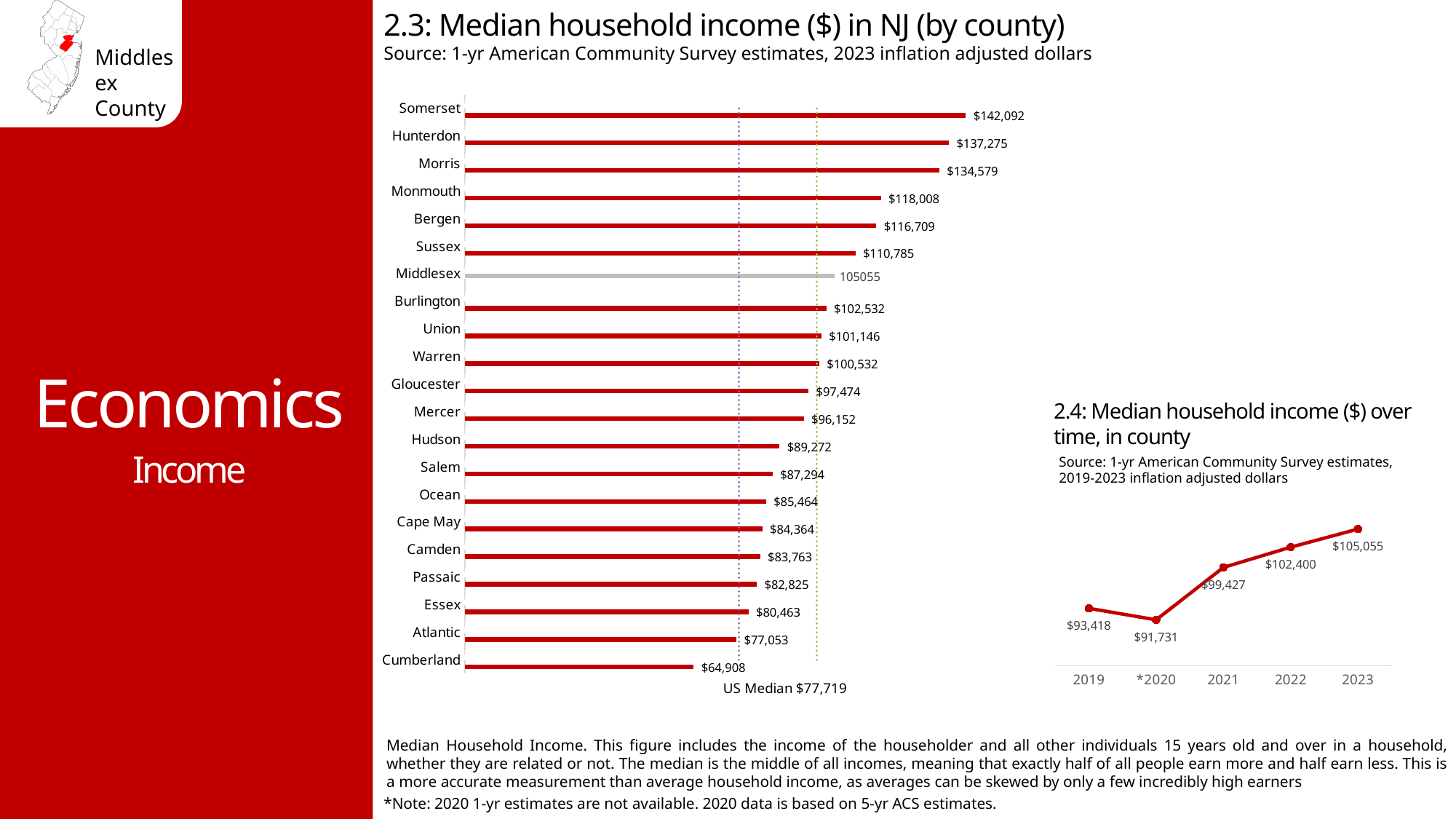
In chart 2.3 (Median household income in NJ by county), what is the median household income for Somerset? $142,092 In chart 2.4 (Median household income over time, in county), what is the value for 2021? $99,427 In chart 2.3 (Median household income in NJ by county), which has a higher median household income, Bergen or Hudson? Bergen What type of chart is chart 2.3 (Median household income in NJ by county)? Bar chart In chart 2.4 (Median household income over time, in county), what is the difference between the 2023 and 2019 values? $11,637 In chart 2.4 (Median household income over time, in county), do the values rise or fall from 2020 to 2023? Rise In chart 2.3 (Median household income in NJ by county), which county has the lowest median household income? Cumberland In chart 2.3 (Median household income in NJ by county), which county has the highest median household income? Somerset In chart 2.3 (Median household income in NJ by county), how many counties are shown? 21 In chart 2.3 (Median household income in NJ by county), what is the difference between Somerset's and Cumberland's median household income? $77,184 In chart 2.4 (Median household income over time, in county), which year has the lowest value? 2020 In chart 2.3 (Median household income in NJ by county), what is the median household income for Middlesex? 105055